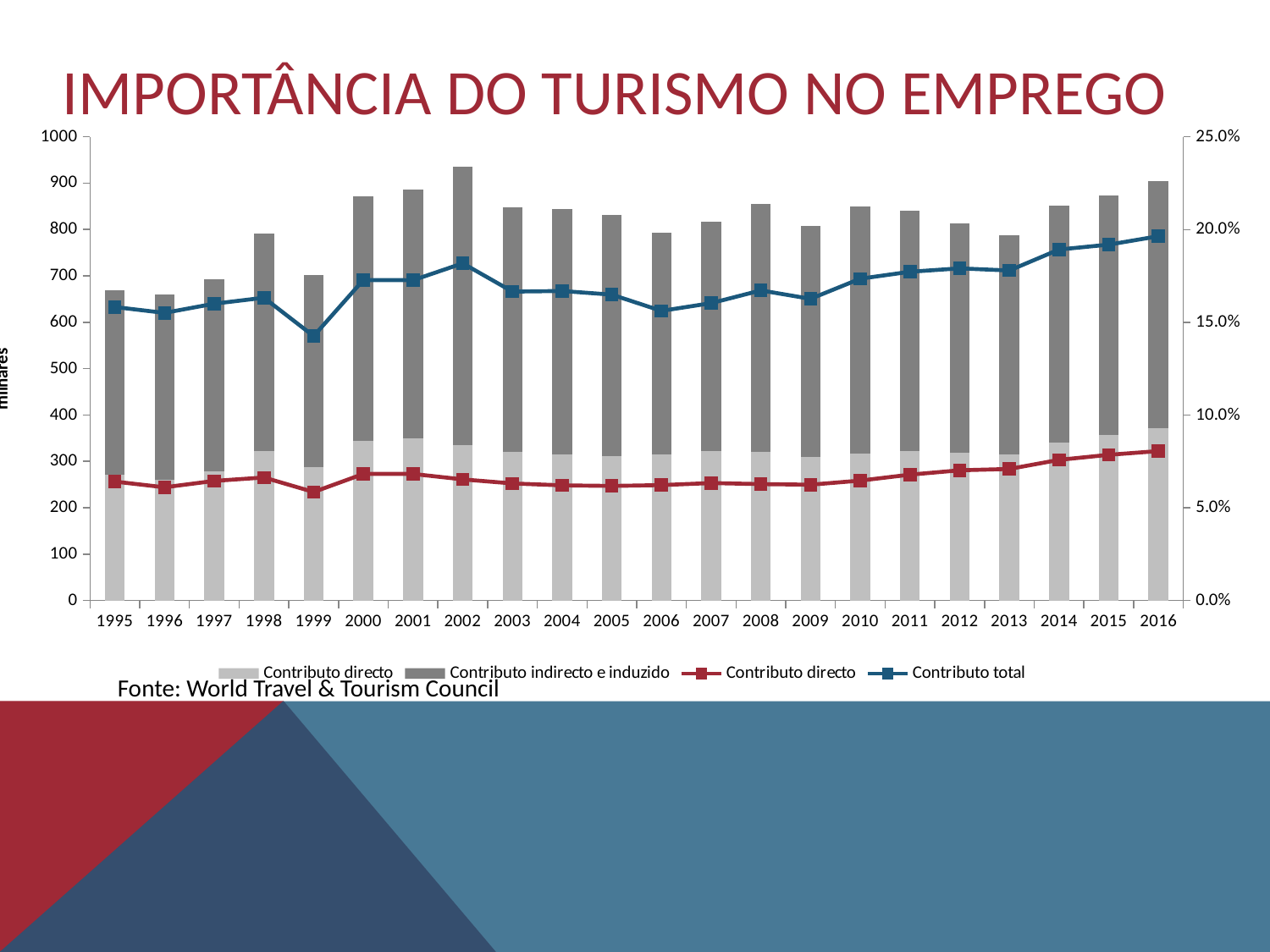
What kind of chart is shown on the slide? A combined stacked bar and line chart Which year has the larger total stacked bar, 2002 or 2009? 2002 Is the total stacked bar for 1999 greater or less than 800? less How many series does the legend list? 4 Does the Contributo total line rise or fall from 2009 to 2016? Rises In which year is the total stacked bar (Contributo directo plus Contributo indirecto e induzido) the highest? 2002 What is the title of the chart on the slide? IMPORTÂNCIA DO TURISMO NO EMPREGO In which year is the Contributo total line at its lowest? 1999 In which year is the Contributo total line at its highest? 2016 Is the Contributo total value for 1999 greater or less than 15.0%? less How many years are shown along the x axis? 22 Is the total stacked bar for 2002 greater or less than 900? greater